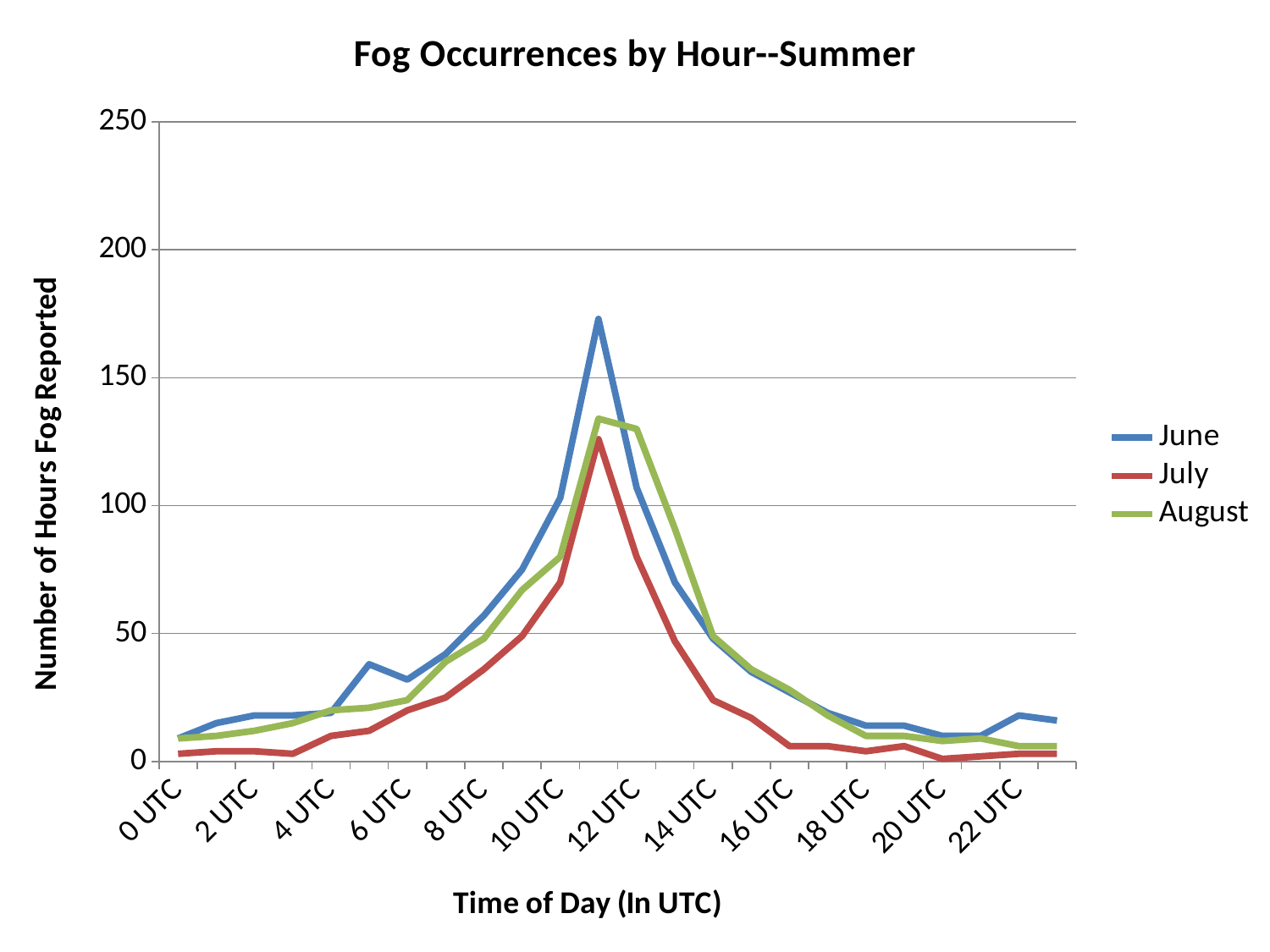
What kind of chart is shown on the slide? line chart What is the title of the chart? Fog Occurrences by Hour--Summer Does the June series rise or fall between 12 UTC and 18 UTC? fall Is the peak value of the June series greater or less than 150? greater How many series does the legend list? 3 Is the value for June at 0 UTC greater or less than 50? less At 12 UTC, which is larger, the value for June or the value for August? August At 16 UTC, which is larger, the value for June or the value for July? June Which series reaches the highest peak value? June Is the peak value of the July series greater or less than 150? less What is the label of the vertical axis? Number of Hours Fog Reported